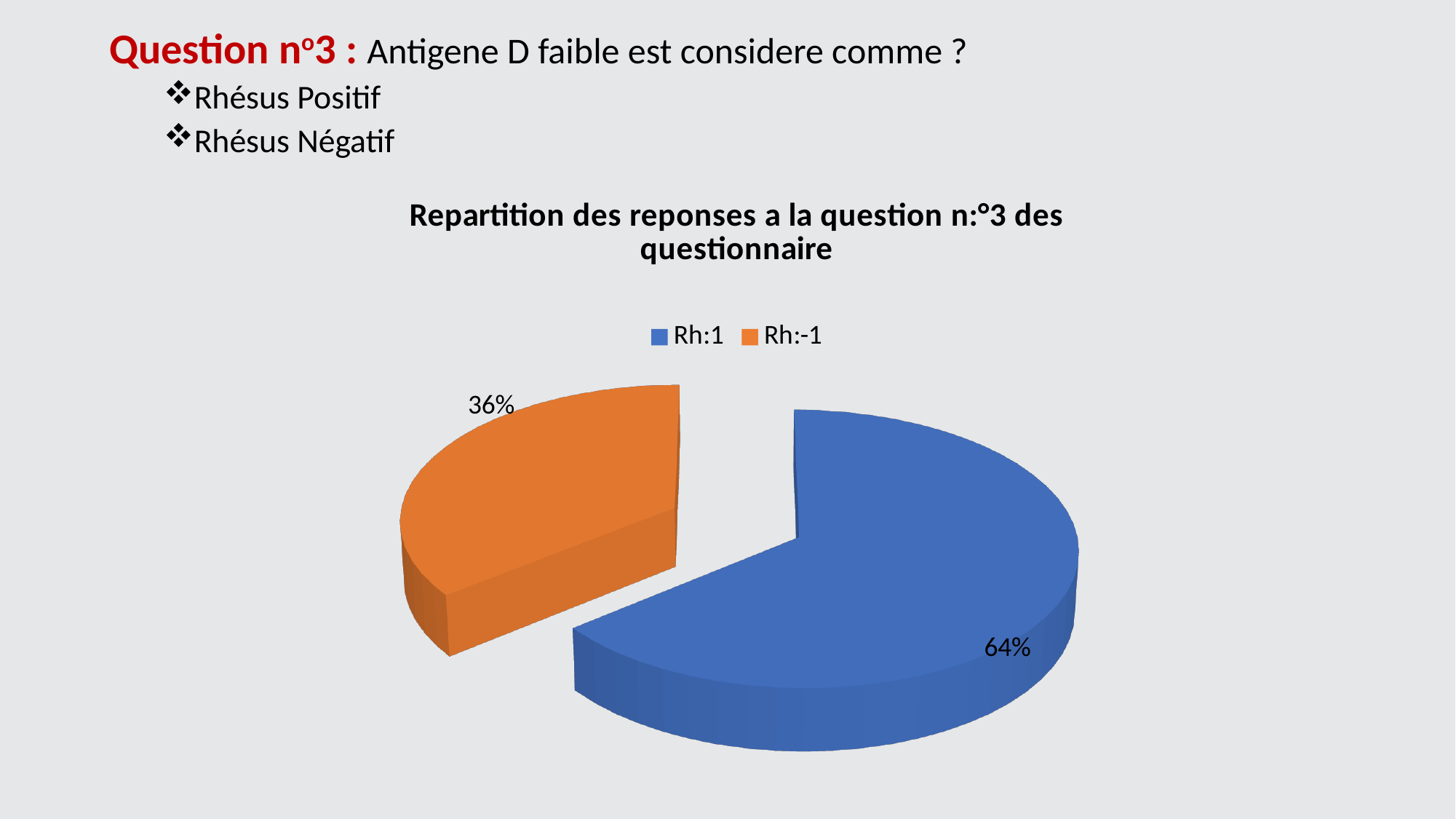
Which category has the largest slice of the pie? Rh:1 How many entries does the legend list? 2 What colour is the Rh:-1 slice? Orange What is the difference in percentage points between the Rh:1 and Rh:-1 slices? 28 What kind of chart is shown on the slide? Pie chart What is the title of the chart? Repartition des reponses a la question n:°3 des questionnaire Is the share for Rh:1 greater or less than 50%? greater How many slices does the pie chart have? 2 Which is larger, the Rh:1 slice or the Rh:-1 slice? Rh:1 What share of the pie does Rh:1 represent? 64% What share of the pie does Rh:-1 represent? 36% Which category has the smallest slice of the pie? Rh:-1